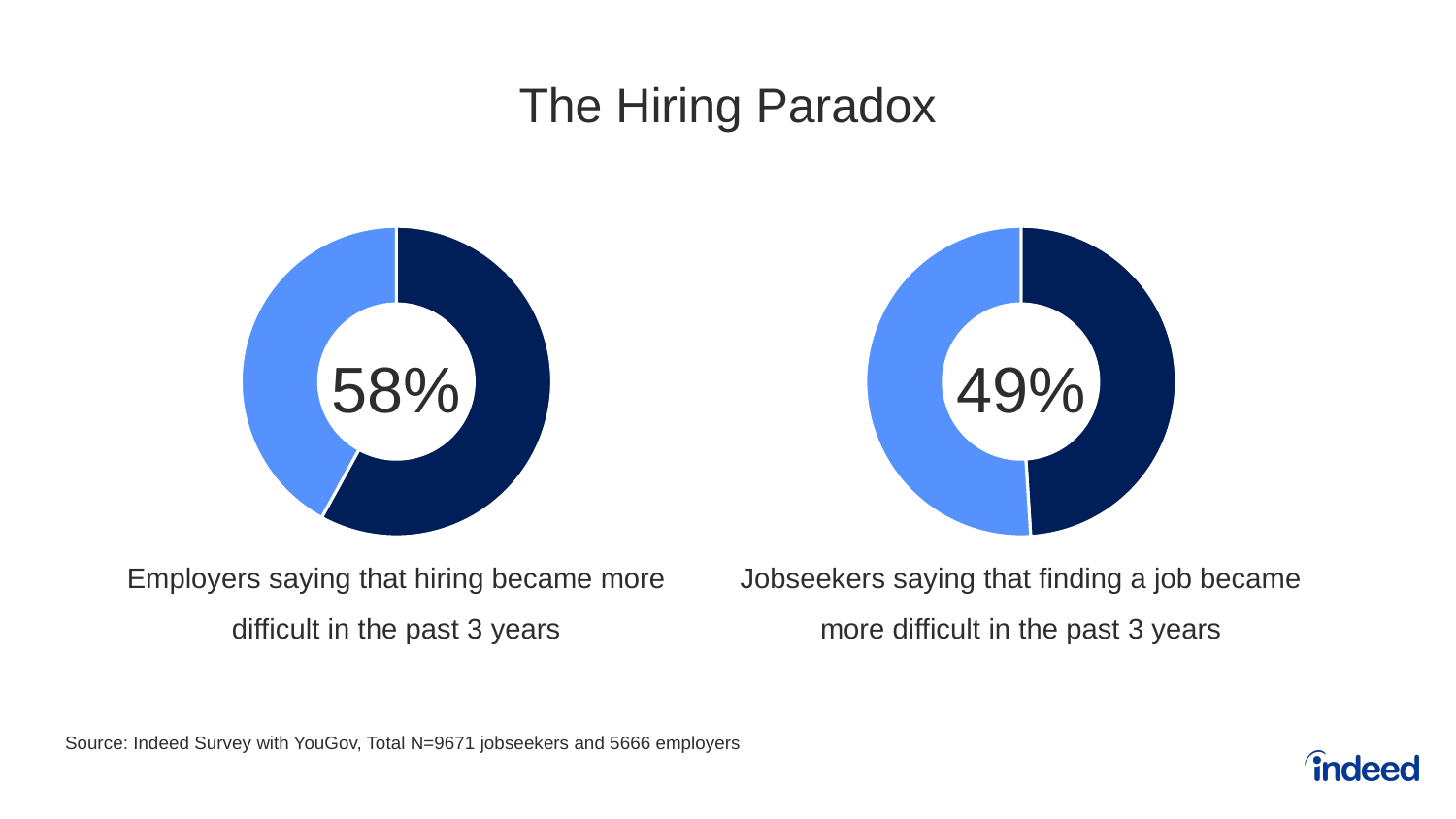
What is the title of the slide containing the two donut charts? The Hiring Paradox On the right chart, what percentage of jobseekers said that finding a job became more difficult in the past 3 years? 49% Which is larger: the percentage of employers saying hiring became more difficult (left chart) or the percentage of jobseekers saying finding a job became more difficult (right chart)? Employers (58%) According to the source note, how many jobseekers were surveyed for the charts? 9671 On the left chart, what percentage of employers said that hiring became more difficult in the past 3 years? 58% On the left chart, what share of the donut does the dark navy slice represent? 58% On the right chart, what share of the donut does the dark navy slice represent? 49% How many slices does the right chart (jobseekers) have? 2 What is the difference in percentage points between the employers' value on the left chart and the jobseekers' value on the right chart? 9 percentage points What kind of chart is used on the left side of the slide for the employers' figure? Donut (pie) chart How many charts are shown on the slide? 2